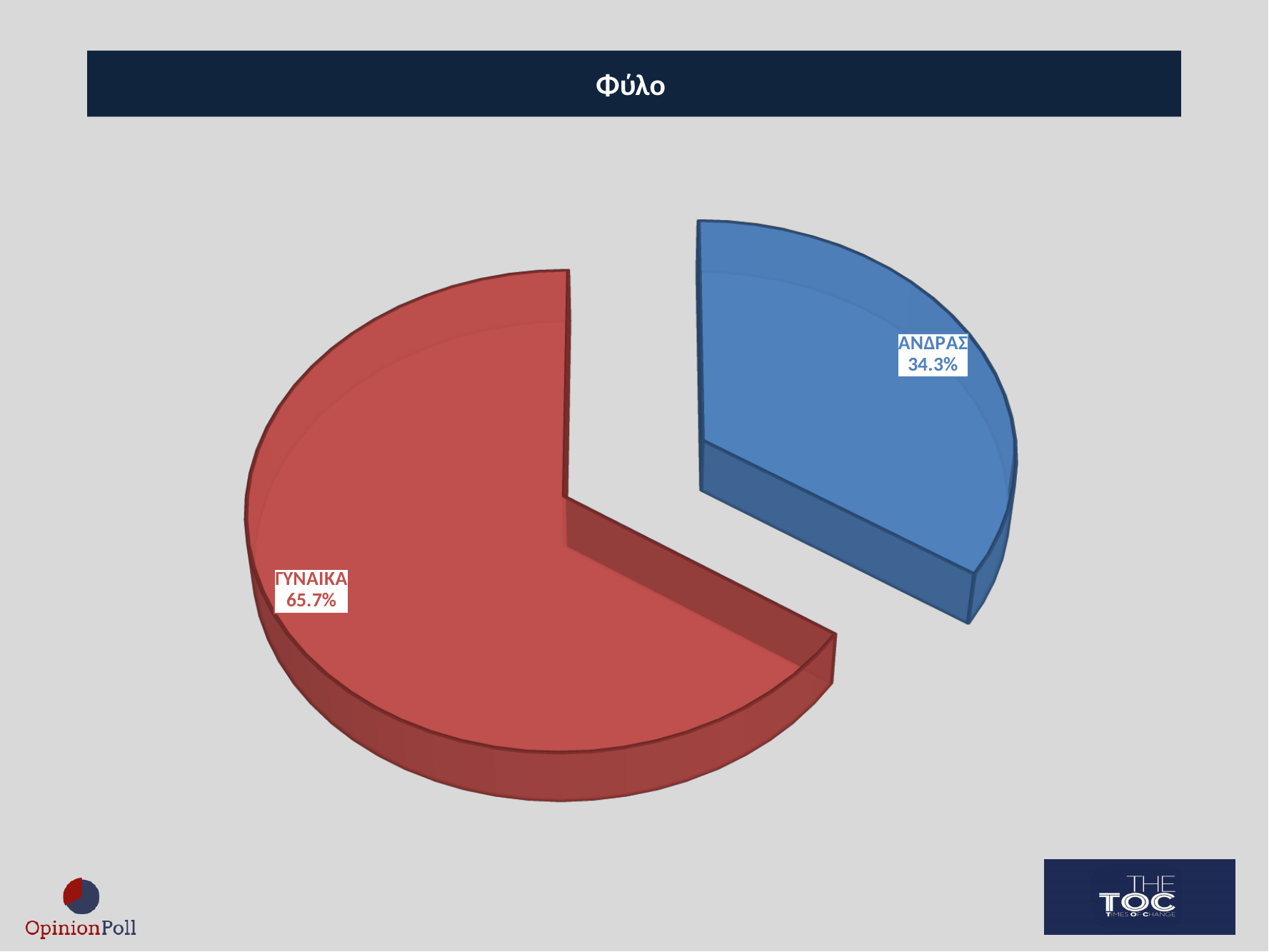
Which category has the smallest share of the pie? ΑΝΔΡΑΣ What percentage does the ΑΝΔΡΑΣ slice show? 34.3% What kind of chart is shown on the slide? Pie chart How many slices does the pie chart have? 2 What is the difference in percentage points between ΓΥΝΑΙΚΑ and ΑΝΔΡΑΣ? 31.4 What share of the pie does the ΑΝΔΡΑΣ slice represent? 34.3% Which is larger, the share for ΑΝΔΡΑΣ or the share for ΓΥΝΑΙΚΑ? ΓΥΝΑΙΚΑ What is the title of the chart? Φύλο Which category has the largest share of the pie? ΓΥΝΑΙΚΑ What percentage does the ΓΥΝΑΙΚΑ slice show? 65.7% What colour is the ΓΥΝΑΙΚΑ slice? Red